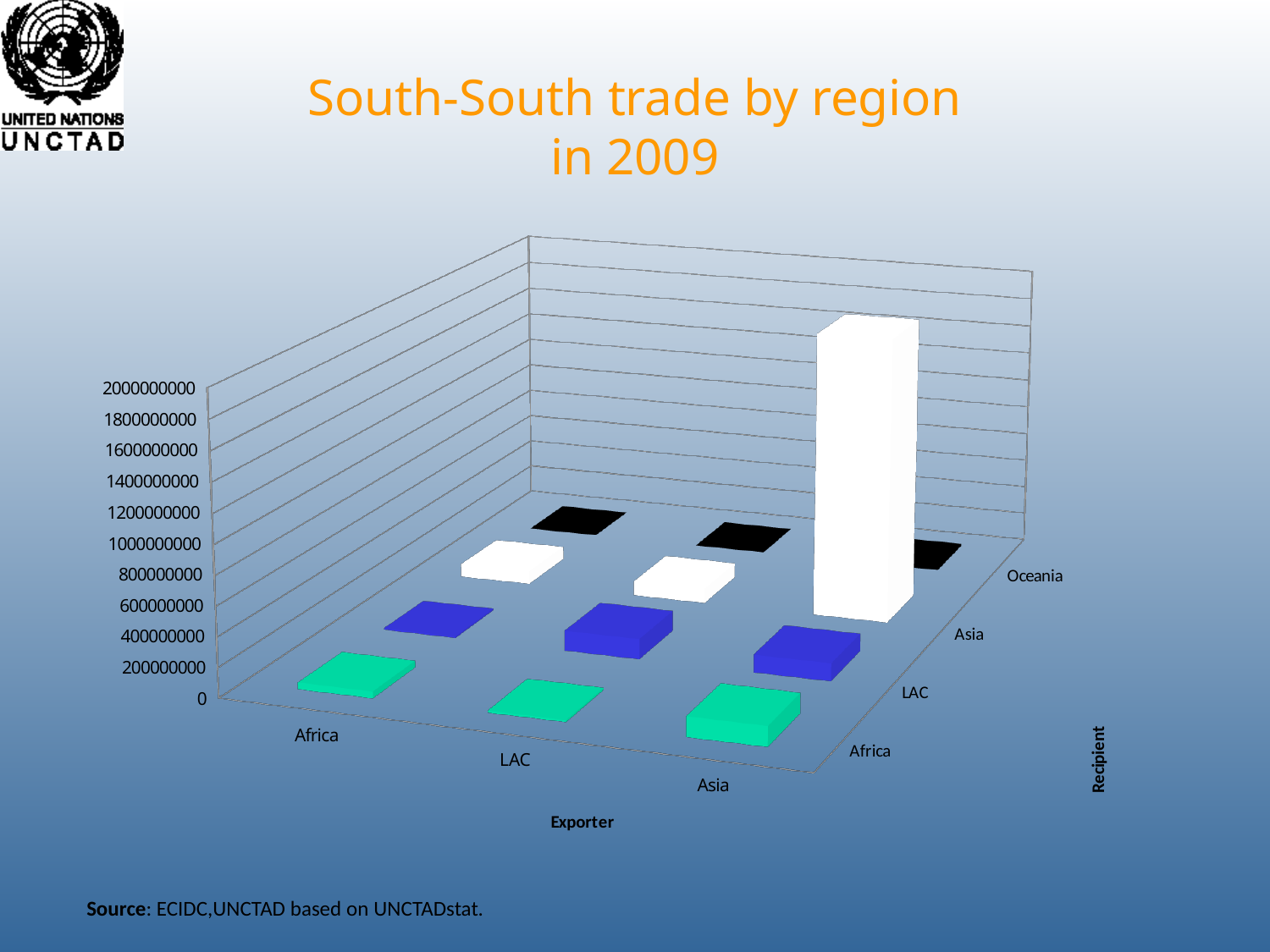
Is the value for trade from Asia to Asia greater or less than 1000000000? greater Which recipient region is listed last (furthest back) on the Recipient axis? Oceania Which is larger: trade from Asia to Asia or trade from Africa to Africa? Asia to Asia What is the title of the chart? South-South trade by region in 2009 Is the value for trade from Africa to Africa greater or less than 400000000? less How many recipient regions are shown along the Recipient axis? 4 Which exporter-recipient combination has the highest trade value? Asia to Asia What kind of chart is shown on the slide? 3D bar chart How many exporter regions are shown along the Exporter axis? 3 What is the highest tick value shown on the vertical axis? 2000000000 Which exporter region is listed first on the Exporter axis? Africa